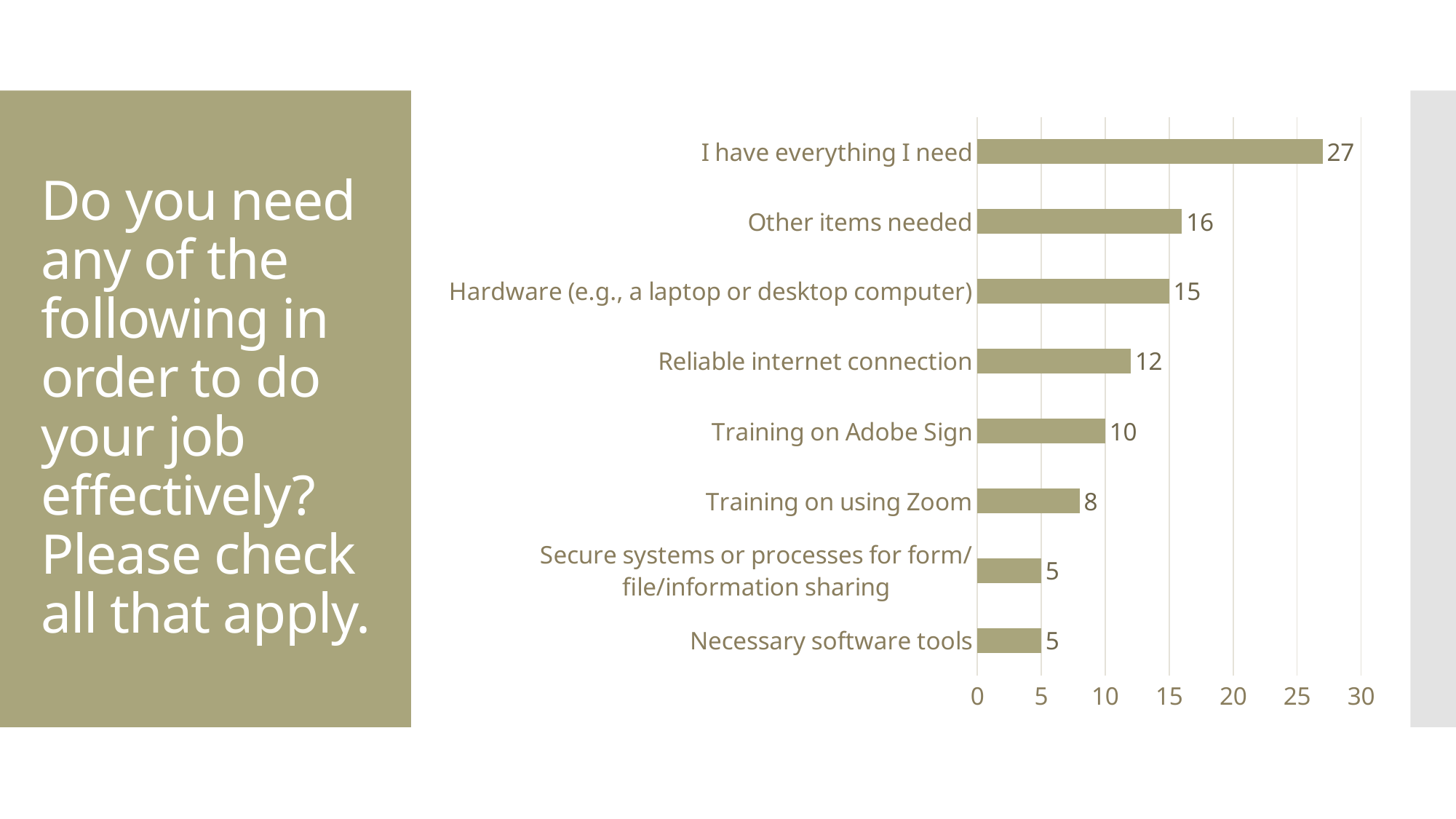
Which category has the highest value? I have everything I need What is the difference between "Other items needed" and "Hardware (e.g., a laptop or desktop computer)"? 1 What is the value for "Reliable internet connection"? 12 Is the value for "Other items needed" greater or less than 20? less What is the value for "Training on Adobe Sign"? 10 Which is larger, "Reliable internet connection" or "Training on Adobe Sign"? Reliable internet connection What is the value for "I have everything I need"? 27 What is the difference between "I have everything I need" and "Training on using Zoom"? 19 How many categories are shown in the chart? 8 What is the value for "Necessary software tools"? 5 What is the value for "Training on using Zoom"? 8 What kind of chart is shown on the slide? bar chart